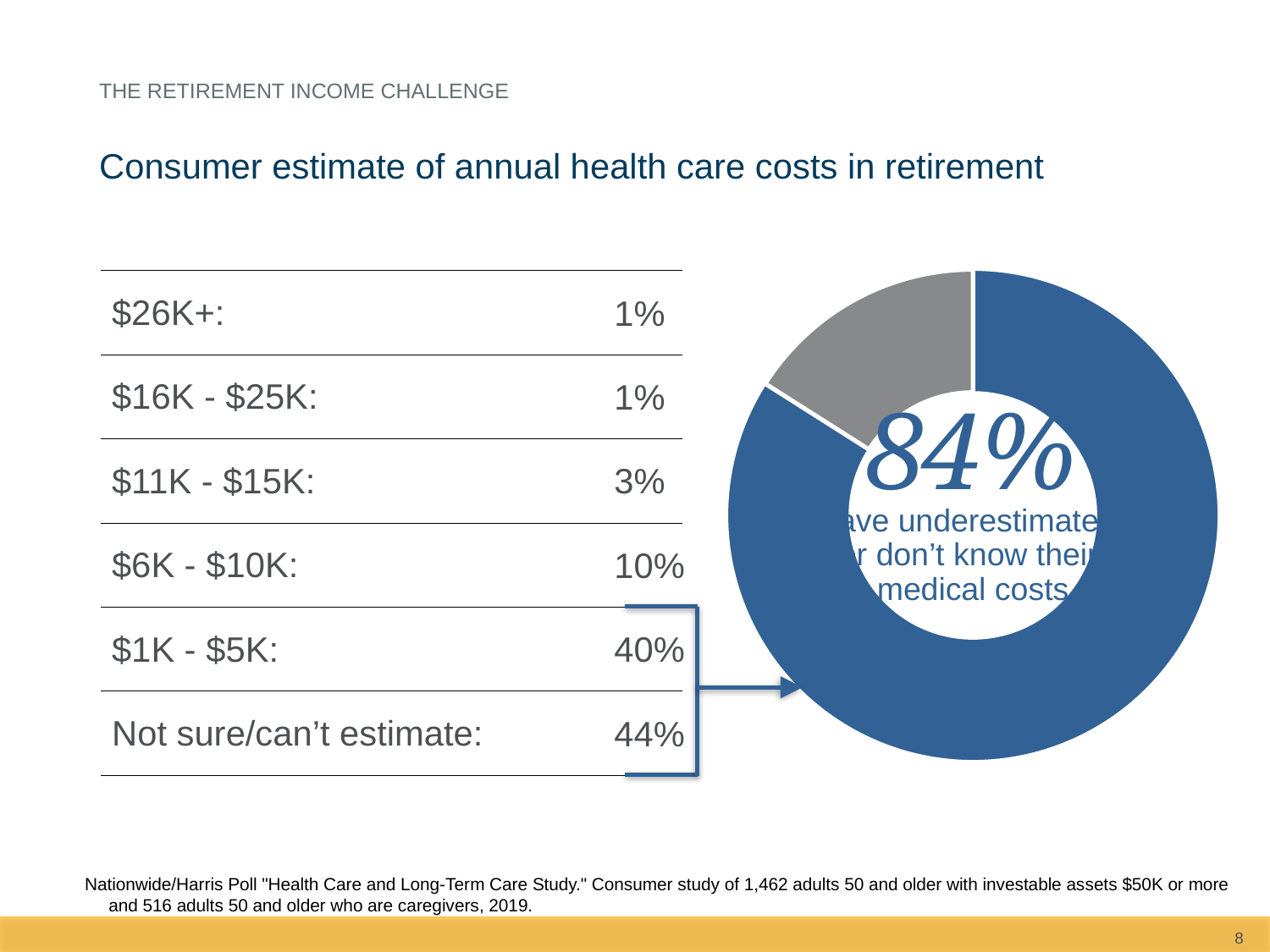
In the table next to the chart, what is the difference between the $1K - $5K and $6K - $10K percentages? 30% What is the title of the slide's chart section? Consumer estimate of annual health care costs in retirement What share of the donut chart does the blue slice represent? 84% Which slice of the donut chart is larger, the blue one or the gray one? Blue How many slices does the donut chart have? 2 In the table next to the chart, what is the combined percentage of $1K - $5K and Not sure/can't estimate? 84% What percentage is printed in the center of the donut chart? 84% In the table next to the chart, what percentage of consumers estimated $1K - $5K? 40% In the table next to the chart, what percentage answered Not sure/can't estimate? 44% What kind of chart is shown on the right of the slide? Pie chart (donut) In the table next to the chart, which category has the highest percentage? Not sure/can't estimate In the table next to the chart, what is the percentage for $6K - $10K? 10%